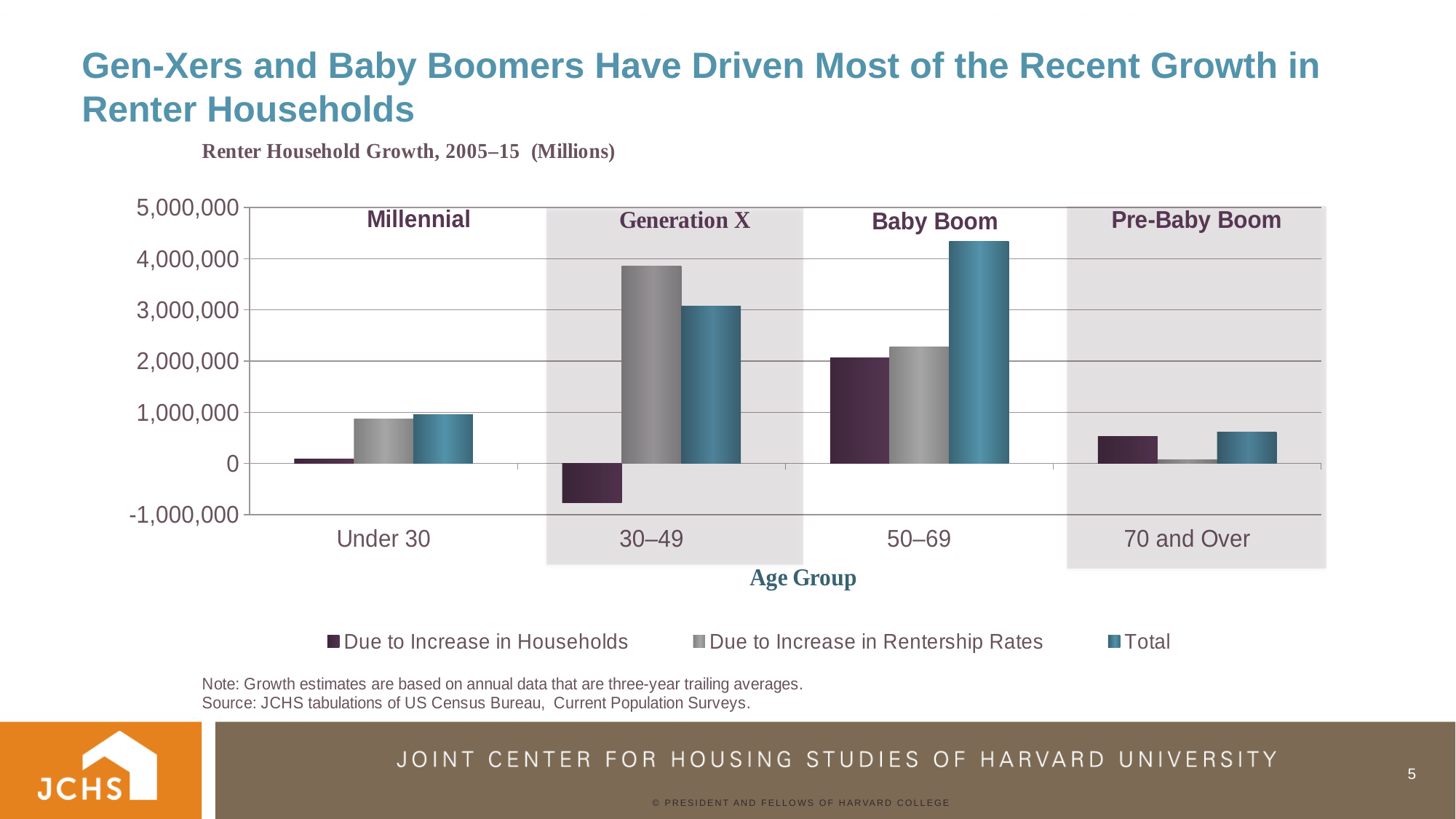
What is the title of the chart? Renter Household Growth, 2005–15 (Millions) Which age group has the highest Total renter household growth? 50–69 Which age group has the larger Due to Increase in Rentership Rates value, 30–49 or 50–69? 30–49 What kind of chart is shown on the slide? bar chart Is the Due to Increase in Households value for the 30–49 age group greater or less than 0? less Which generation label appears above the 30–49 age group in the chart? Generation X How many age groups are shown on the x axis of the chart? 4 Is the Total value for the 50–69 age group greater or less than 4,000,000? greater Which age group has the highest Due to Increase in Households value? 50–69 Is the Total value for the 30–49 age group greater or less than 2,000,000? greater Which age group has the lowest Total renter household growth? 70 and Over How many series does the chart's legend list? 3